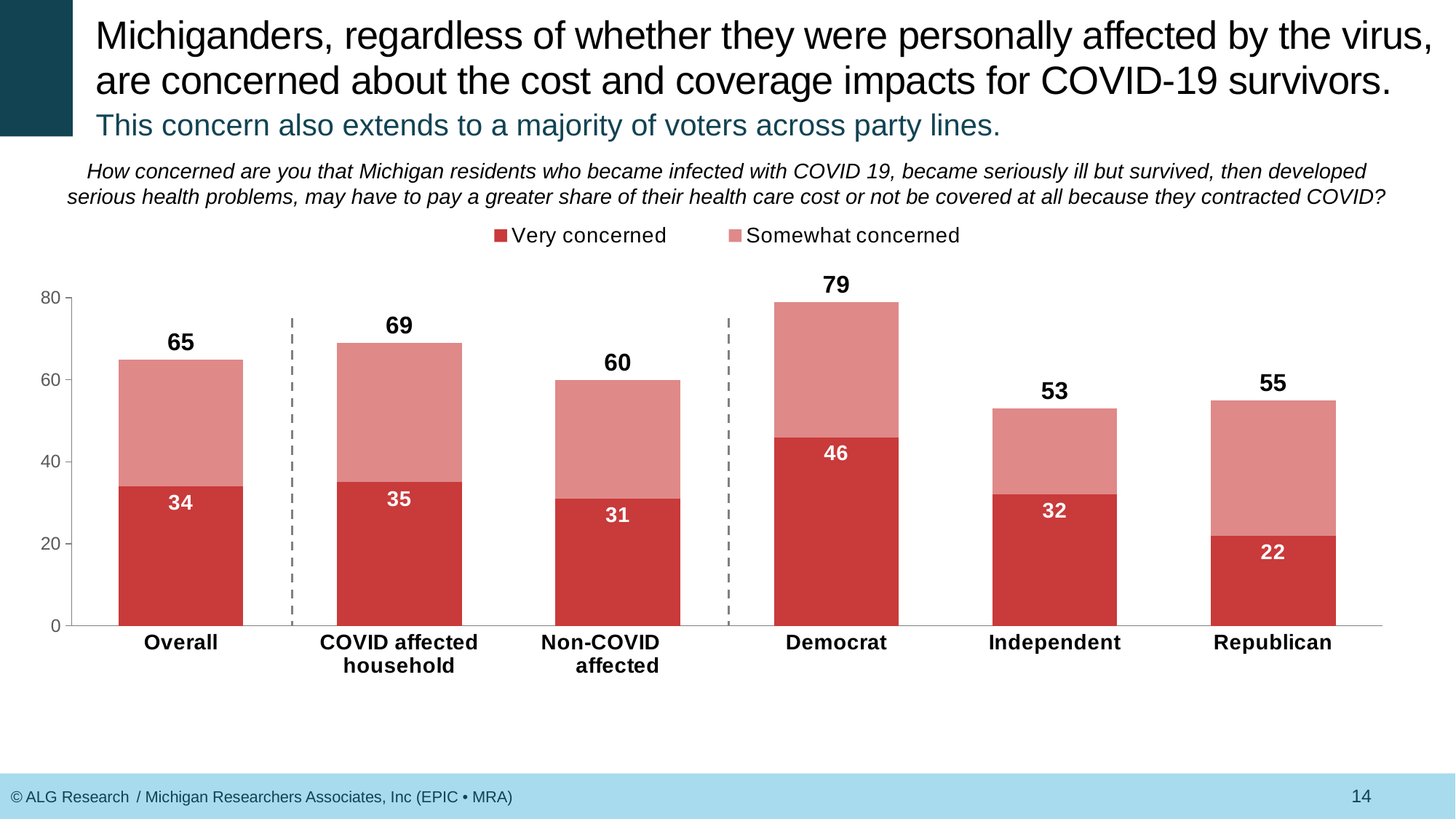
What is the 'Very concerned' value for Non-COVID affected? 31 Which category has the highest total bar? Democrat What is the difference between the Democrat total (79) and the Independent total (53)? 26 What are the two legend entries? Very concerned, Somewhat concerned What kind of chart is shown on the slide? Stacked bar chart What is the total labeled above the Republican bar? 55 Is the total for Republican greater or less than 60? less What is the 'Very concerned' value for Democrat? 46 How many categories are shown on the x axis? 6 How many series does the legend list? 2 Which has a larger 'Very concerned' value: Overall or COVID affected household? COVID affected household Which category has the lowest total bar? Independent